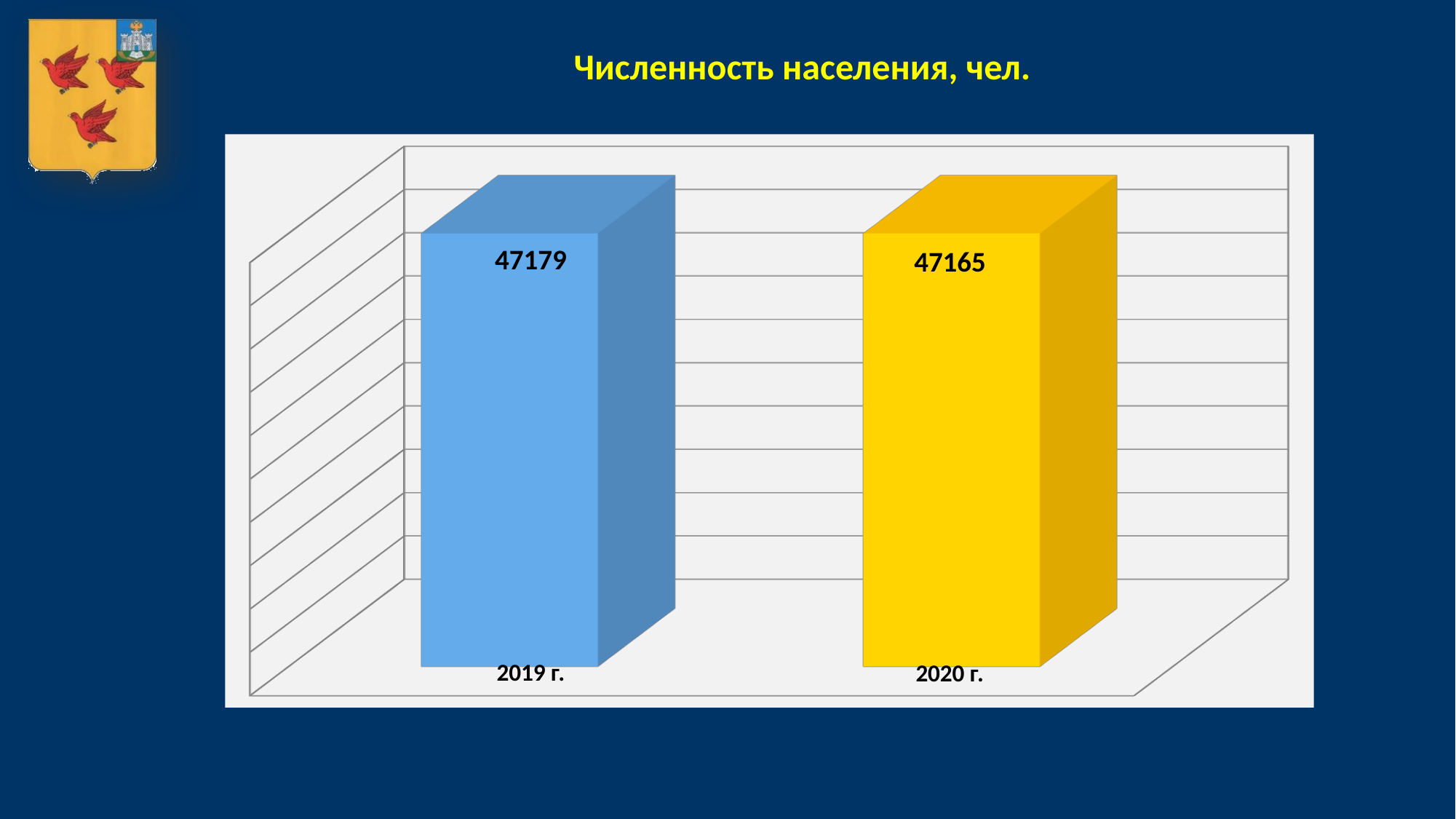
What is the title of the chart? Численность населения, чел. What kind of chart is shown on the slide? bar chart Is the value for 2019 г. larger or smaller than the value for 2020 г.? larger What colour is the bar for 2020 г.? yellow Which year has the lower population value? 2020 г. What is the population value shown for 2020 г.? 47165 How many categories (years) are plotted on the chart? 2 Do the values rise or fall from 2019 г. to 2020 г.? fall What is the population value shown for 2019 г.? 47179 What is the difference between the 2019 г. and 2020 г. values? 14 Which year has the higher population value? 2019 г.